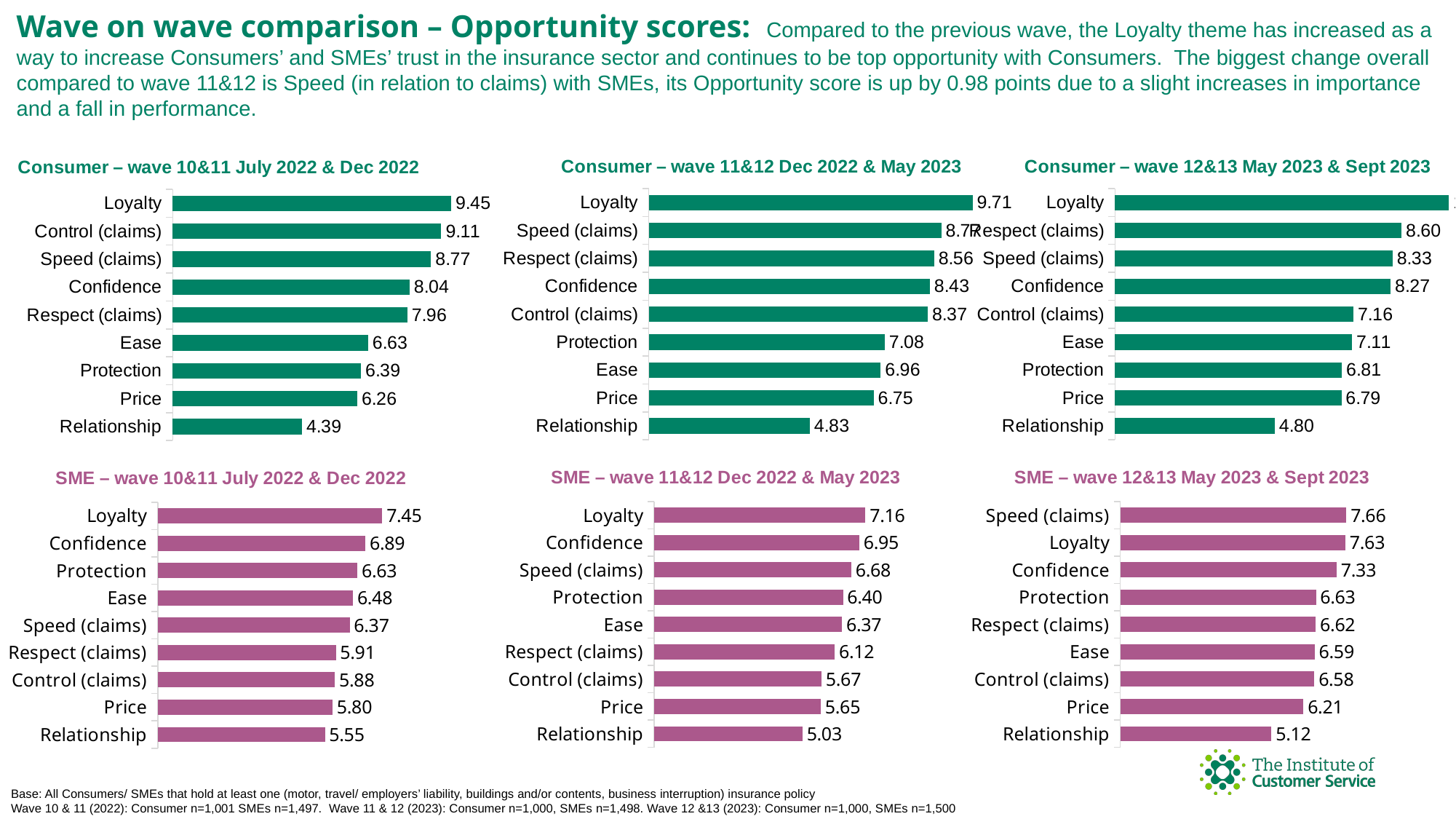
In the 'Consumer – wave 10&11 July 2022 & Dec 2022' chart, which category has the lowest value? Relationship In the 'Consumer – wave 11&12 Dec 2022 & May 2023' chart, what is the difference between Loyalty and Relationship? 4.88 What type of chart is the 'SME – wave 11&12 Dec 2022 & May 2023' chart? Bar chart In the 'Consumer – wave 11&12 Dec 2022 & May 2023' chart, what is the value for Confidence? 8.43 In the 'Consumer – wave 12&13 May 2023 & Sept 2023' chart, which is larger, Ease or Protection? Ease In the 'SME – wave 11&12 Dec 2022 & May 2023' chart, what is the value for Speed (claims)? 6.68 In the 'SME – wave 12&13 May 2023 & Sept 2023' chart, which category has the highest value? Speed (claims) In the 'SME – wave 10&11 July 2022 & Dec 2022' chart, what is the value for Protection? 6.63 In the 'SME – wave 12&13 May 2023 & Sept 2023' chart, what is the difference between Speed (claims) and Loyalty? 0.03 In the 'Consumer – wave 10&11 July 2022 & Dec 2022' chart, what is the value for Loyalty? 9.45 In the 'Consumer – wave 12&13 May 2023 & Sept 2023' chart, what is the value for Respect (claims)? 8.60 In the 'SME – wave 10&11 July 2022 & Dec 2022' chart, how many categories are shown? 9